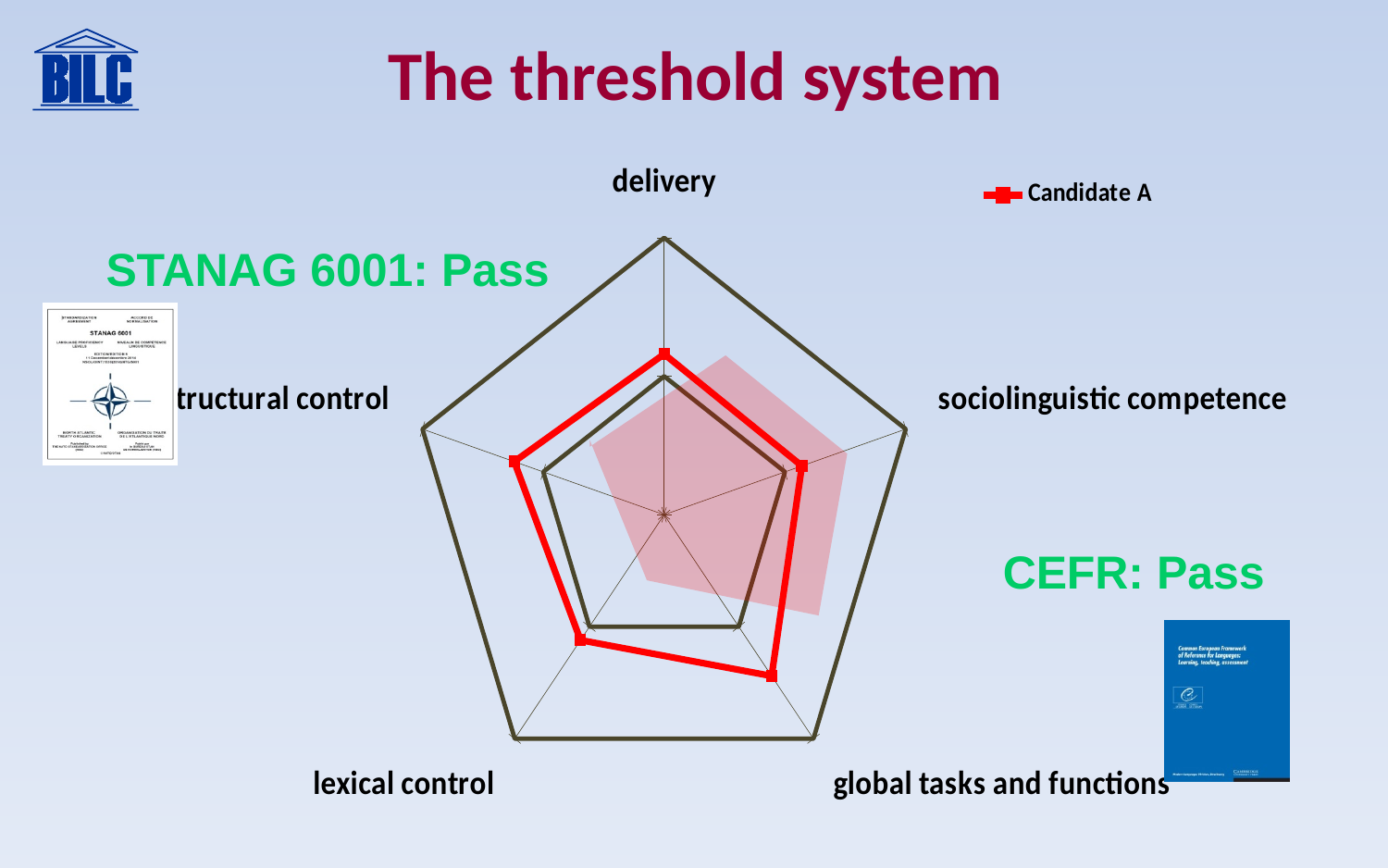
Which category label appears at the top axis of the radar chart? delivery Which category label appears at the bottom-right axis of the radar chart? global tasks and functions How many series does the legend of the radar chart list? 1 What colour is the Candidate A line on the radar chart? Red What is the name of the series shown in the legend of the radar chart? Candidate A Which category label appears at the bottom-left axis of the radar chart? lexical control Which category label appears at the right-hand axis of the radar chart? sociolinguistic competence What kind of chart is shown on the slide? Radar chart How many axes (categories) does the radar chart have? 5